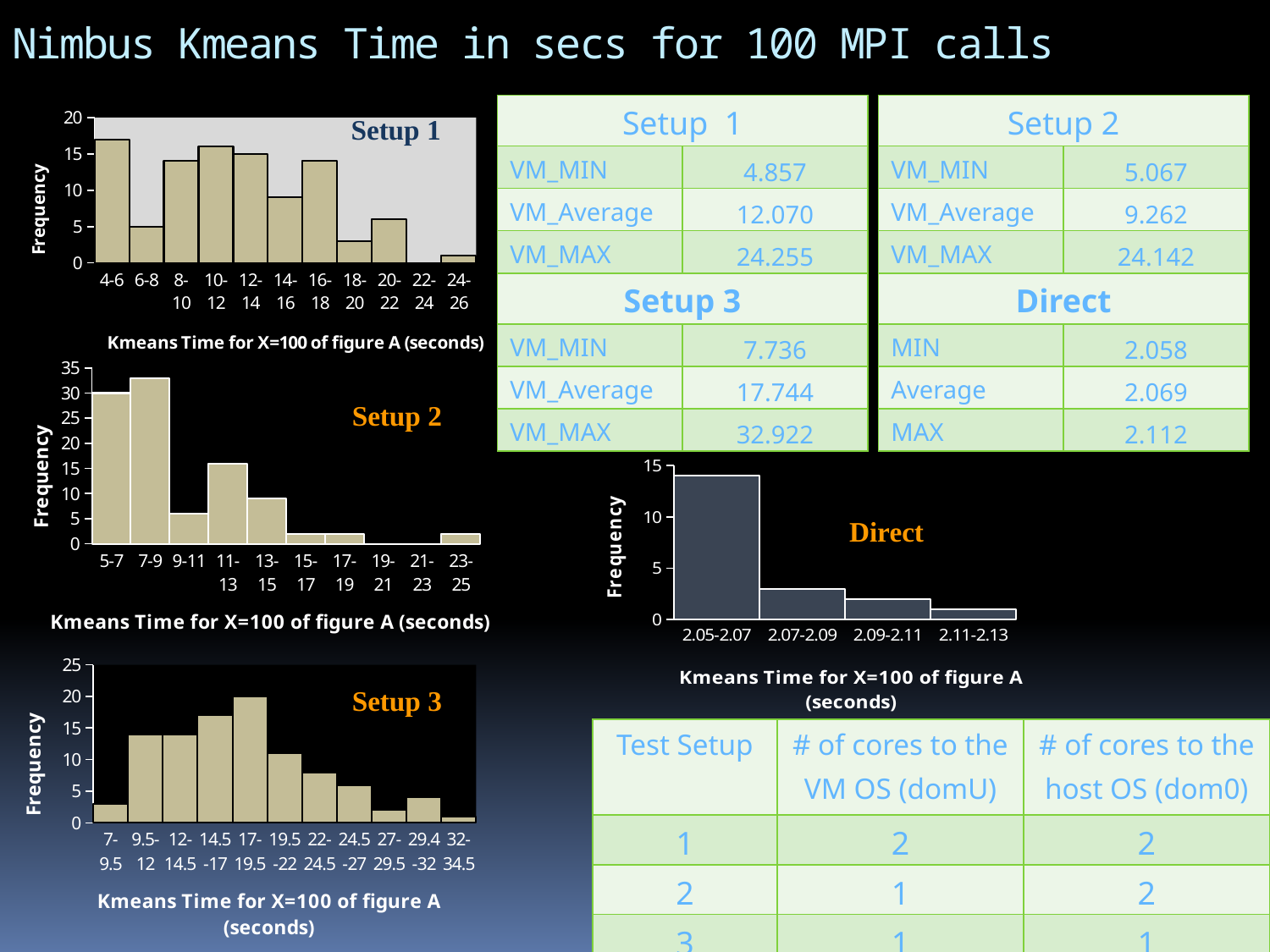
In the Setup 1 chart, is the frequency for the 4-6 bin greater or less than 15? greater In the Direct chart, which bin has the highest frequency? 2.05-2.07 In the Setup 2 chart, which bin has the larger frequency, 5-7 or 11-13? 5-7 What is the y-axis label on the Setup 3 chart? Frequency What kind of chart is the Setup 1 chart? bar chart How many bins (categories) are shown on the x axis of the Setup 2 chart? 10 In the Setup 3 chart, which bin has the highest frequency? 17-19.5 In the Direct chart, is the frequency for the 2.07-2.09 bin greater or less than 5? less How many bins (categories) are shown on the x axis of the Direct chart? 4 In the Direct chart, do the frequencies rise or fall moving left to right along the x axis? fall In the Direct chart, which bin has the lowest frequency? 2.11-2.13 In the Setup 2 chart, which bin has the highest frequency? 7-9